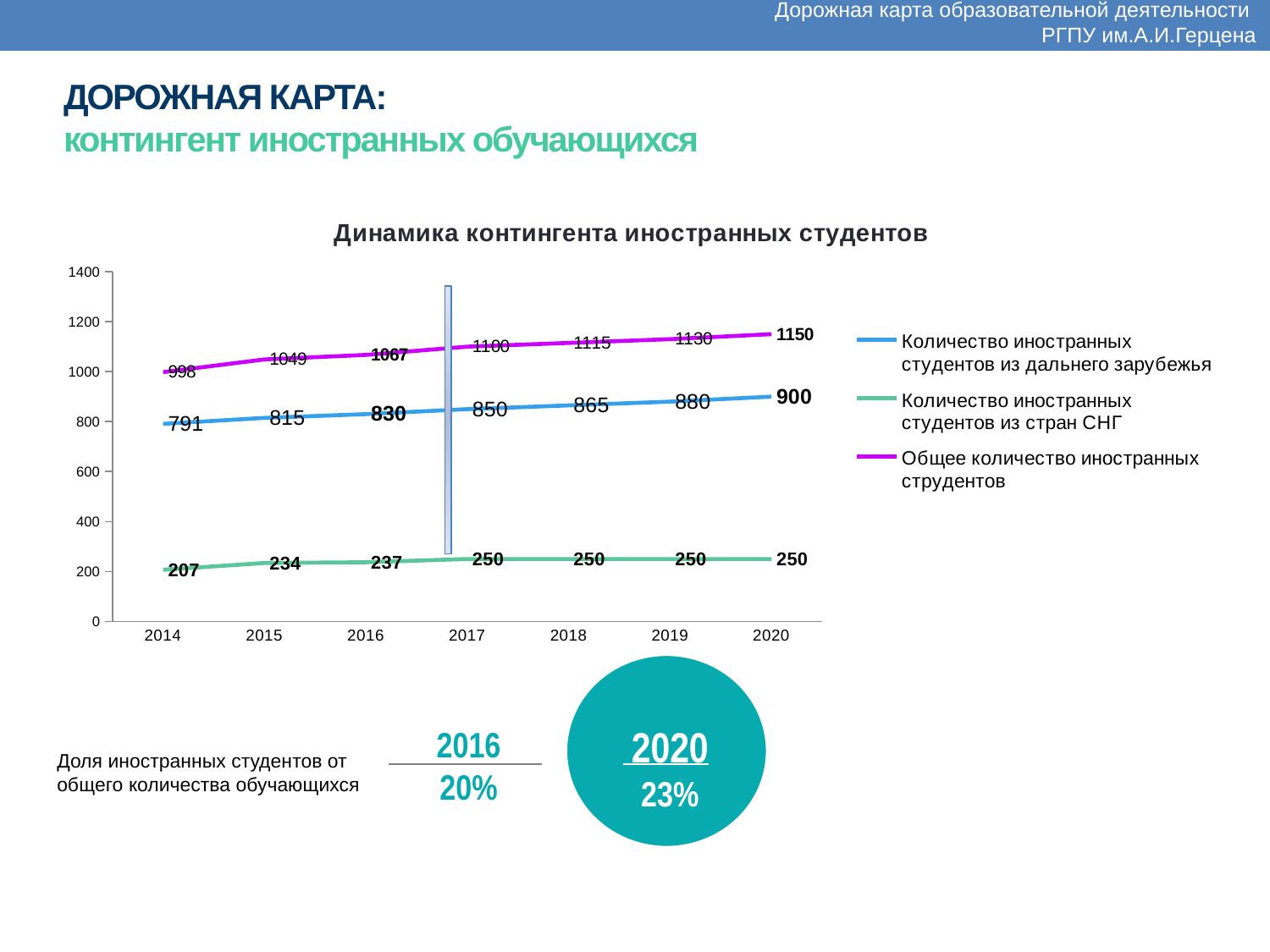
How many years are plotted along the x axis? 7 What is the value for 'Количество иностранных студентов из стран СНГ' in 2015? 234 How many series does the legend list? 3 What is the title of the chart? Динамика контингента иностранных студентов In which year is 'Количество иностранных студентов из дальнего зарубежья' highest? 2020 Which is larger in 2017: 'Количество иностранных студентов из дальнего зарубежья' or 'Количество иностранных студентов из стран СНГ'? Количество иностранных студентов из дальнего зарубежья What is the difference between the 2020 and 2014 values of 'Количество иностранных студентов из дальнего зарубежья'? 109 What type of chart is shown on the slide? line chart Does 'Общее количество иностранных струдентов' rise or fall from 2014 to 2020? rise What is the value for 'Количество иностранных студентов из дальнего зарубежья' in 2014? 791 What is the value for 'Общее количество иностранных струдентов' in 2020? 1150 In which year is 'Общее количество иностранных струдентов' lowest? 2014